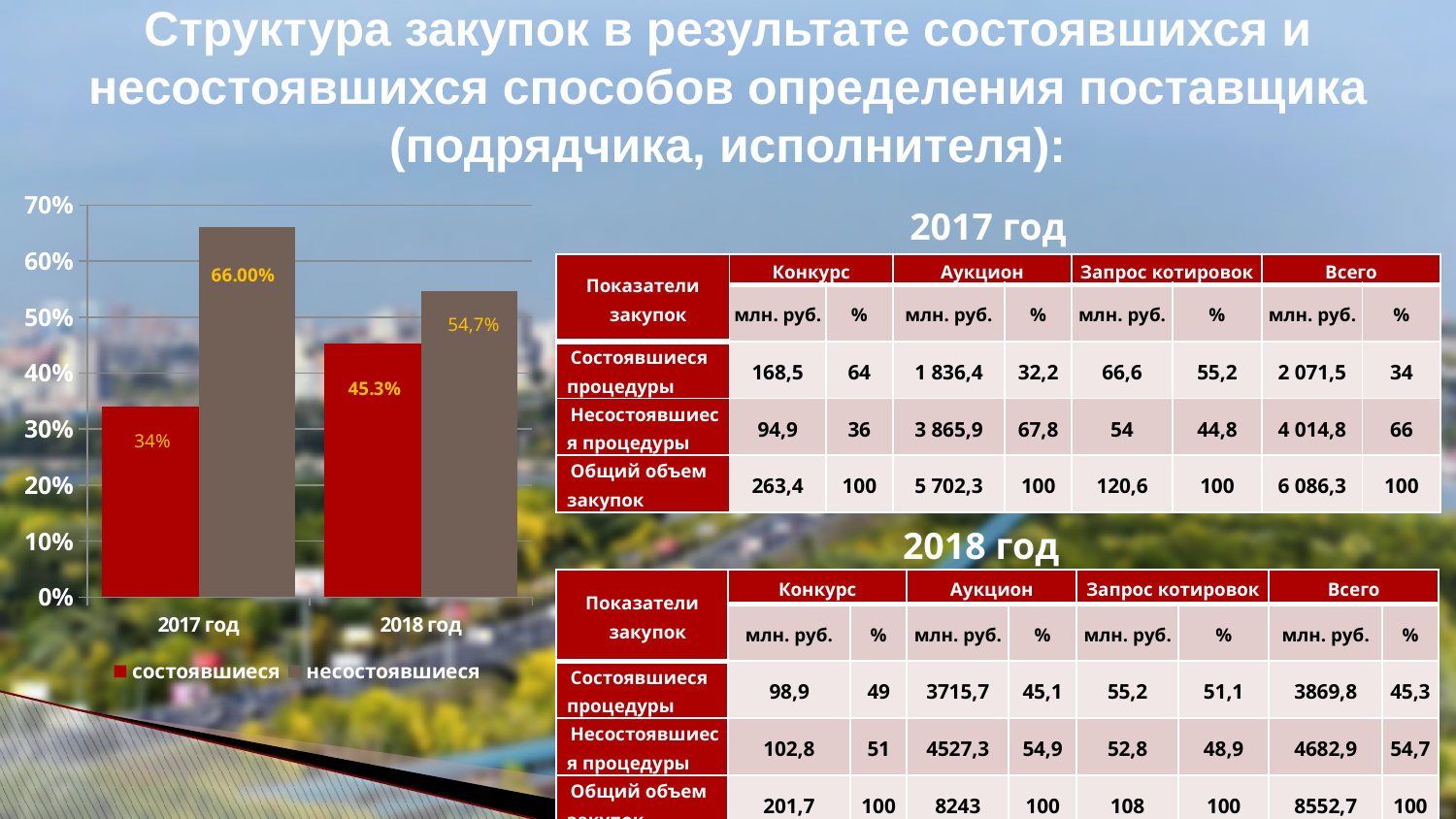
How many series does the chart legend list? 2 How many categories are shown on the x axis of the chart? 2 What is the value for несостоявшиеся in 2017 год? 66.00% What is the value for состоявшиеся in 2017 год? 34% Which bar in the chart is the highest? несостоявшиеся, 2017 год What is the value for несостоявшиеся in 2018 год? 54,7% What type of chart is shown on the left of the slide? bar chart Which bar in the chart is the lowest? состоявшиеся, 2017 год Does the value for состоявшиеся rise or fall from 2017 год to 2018 год? rise What is the value for состоявшиеся in 2018 год? 45.3% Which is larger in 2018 год: состоявшиеся or несостоявшиеся? несостоявшиеся What colour are the состоявшиеся bars in the chart? red